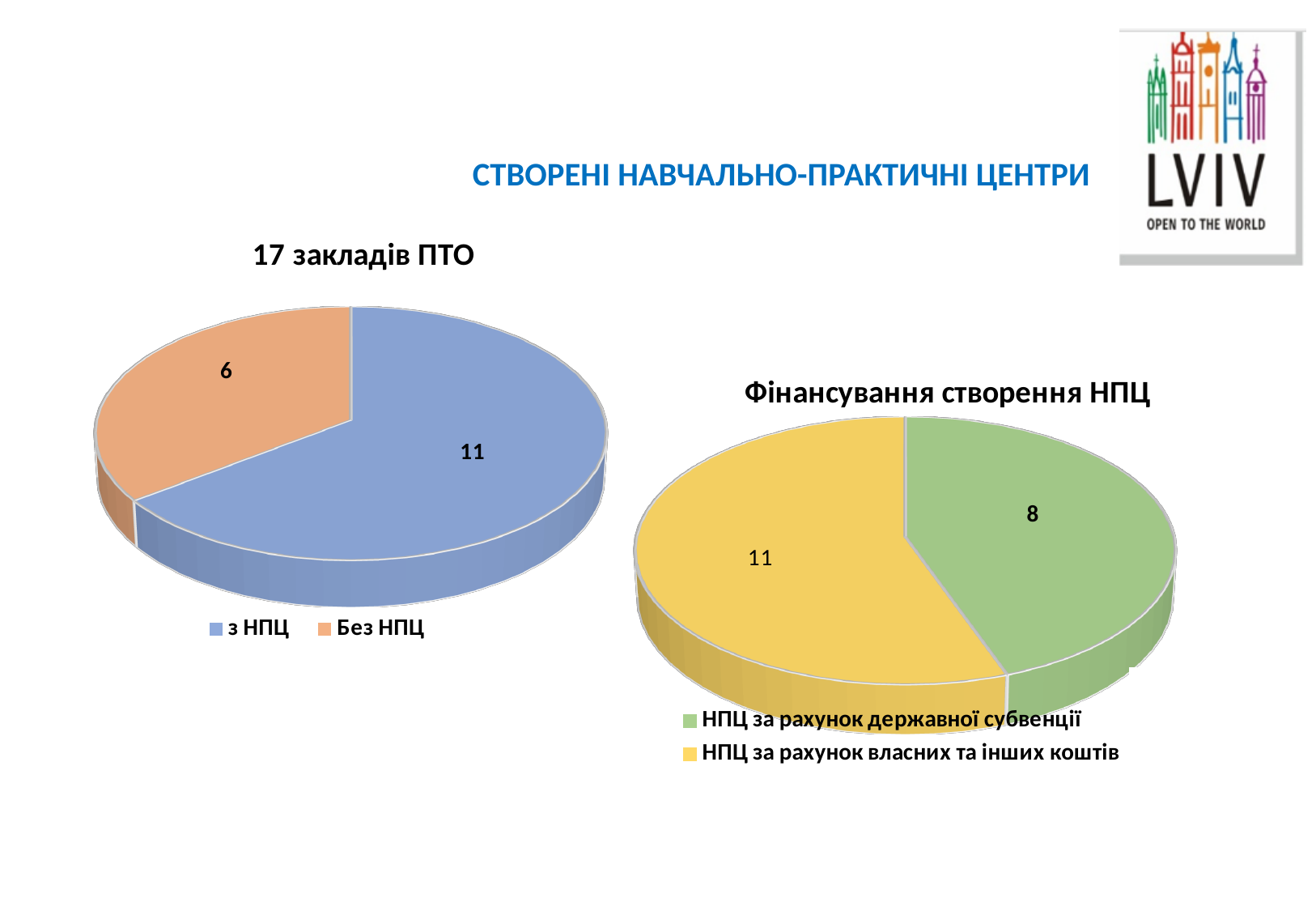
In the chart titled 'Фінансування створення НПЦ', which category has the smallest slice? НПЦ за рахунок державної субвенції In the chart titled '17 закладів ПТО', which category has the largest slice? з НПЦ In the chart titled '17 закладів ПТО', what is the difference between the values for 'з НПЦ' and 'Без НПЦ'? 5 In the chart titled 'Фінансування створення НПЦ', which is larger: 'НПЦ за рахунок державної субвенції' or 'НПЦ за рахунок власних та інших коштів'? НПЦ за рахунок власних та інших коштів In the chart titled '17 закладів ПТО', what is the value for 'Без НПЦ'? 6 In the chart titled 'Фінансування створення НПЦ', what is the difference between the values for 'НПЦ за рахунок власних та інших коштів' and 'НПЦ за рахунок державної субвенції'? 3 In the chart titled '17 закладів ПТО', what colour is the slice for 'Без НПЦ'? Orange How many categories does the chart titled 'Фінансування створення НПЦ' show? 2 What kind of chart is the one titled '17 закладів ПТО'? Pie chart In the chart titled '17 закладів ПТО', what is the value for 'з НПЦ'? 11 In the chart titled 'Фінансування створення НПЦ', what is the value for 'НПЦ за рахунок власних та інших коштів'? 11 In the chart titled 'Фінансування створення НПЦ', what is the value for 'НПЦ за рахунок державної субвенції'? 8